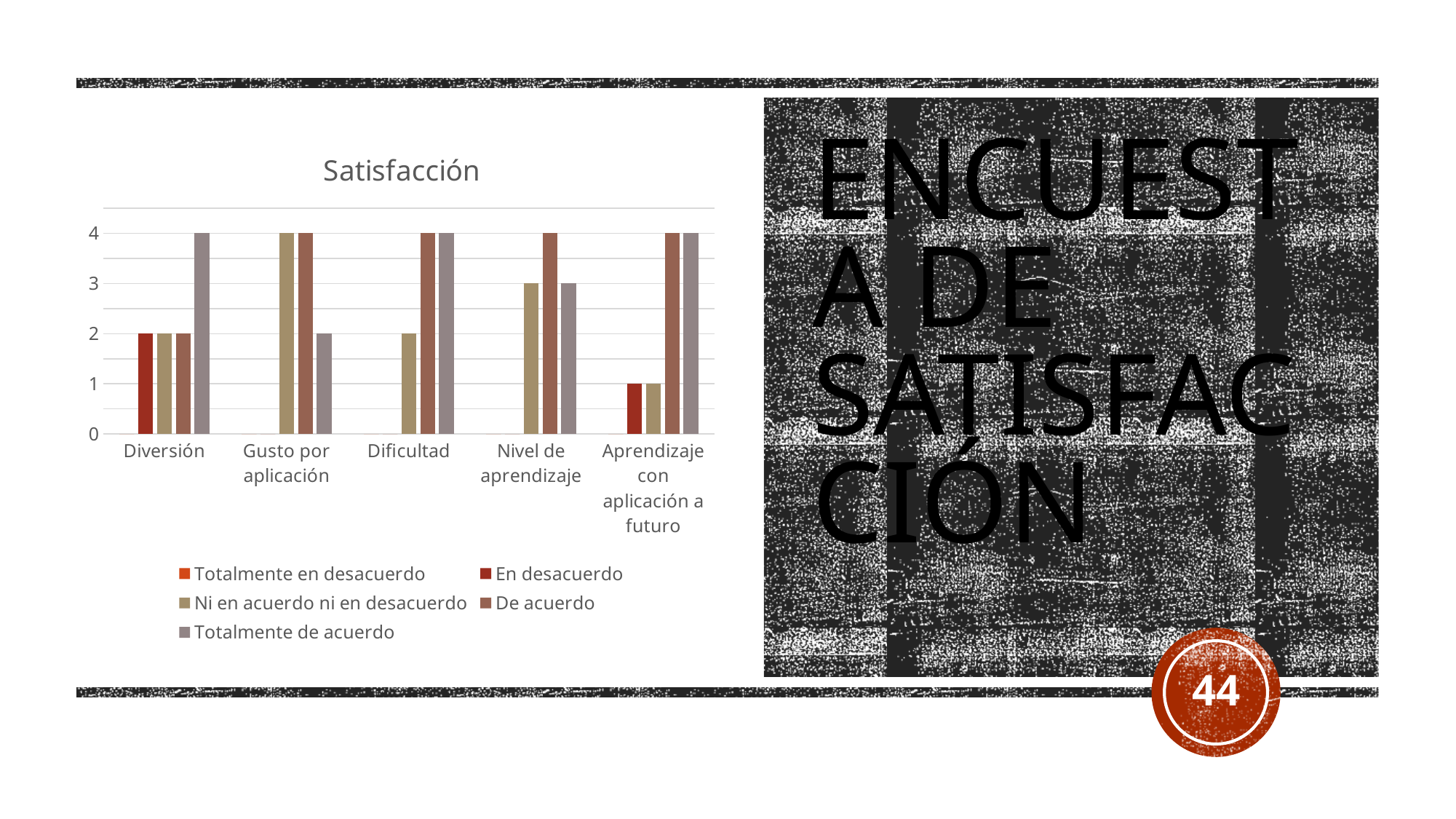
What is the value of 'Totalmente de acuerdo' for Diversión? 4 For Dificultad, which is larger: 'Ni en acuerdo ni en desacuerdo' or 'De acuerdo'? De acuerdo What is the value of 'Ni en acuerdo ni en desacuerdo' for Nivel de aprendizaje? 3 How many categories are shown on the x axis? 5 Which legend entry is shown in orange? Totalmente en desacuerdo What is the value of 'En desacuerdo' for Aprendizaje con aplicación a futuro? 1 What is the value of 'Totalmente de acuerdo' for Gusto por aplicación? 2 How many series does the legend list? 5 What is the difference between 'De acuerdo' and 'Totalmente de acuerdo' for Gusto por aplicación? 2 Which category has the highest value for 'En desacuerdo'? Diversión What type of chart is shown on the slide? bar chart What is the title of the chart? Satisfacción